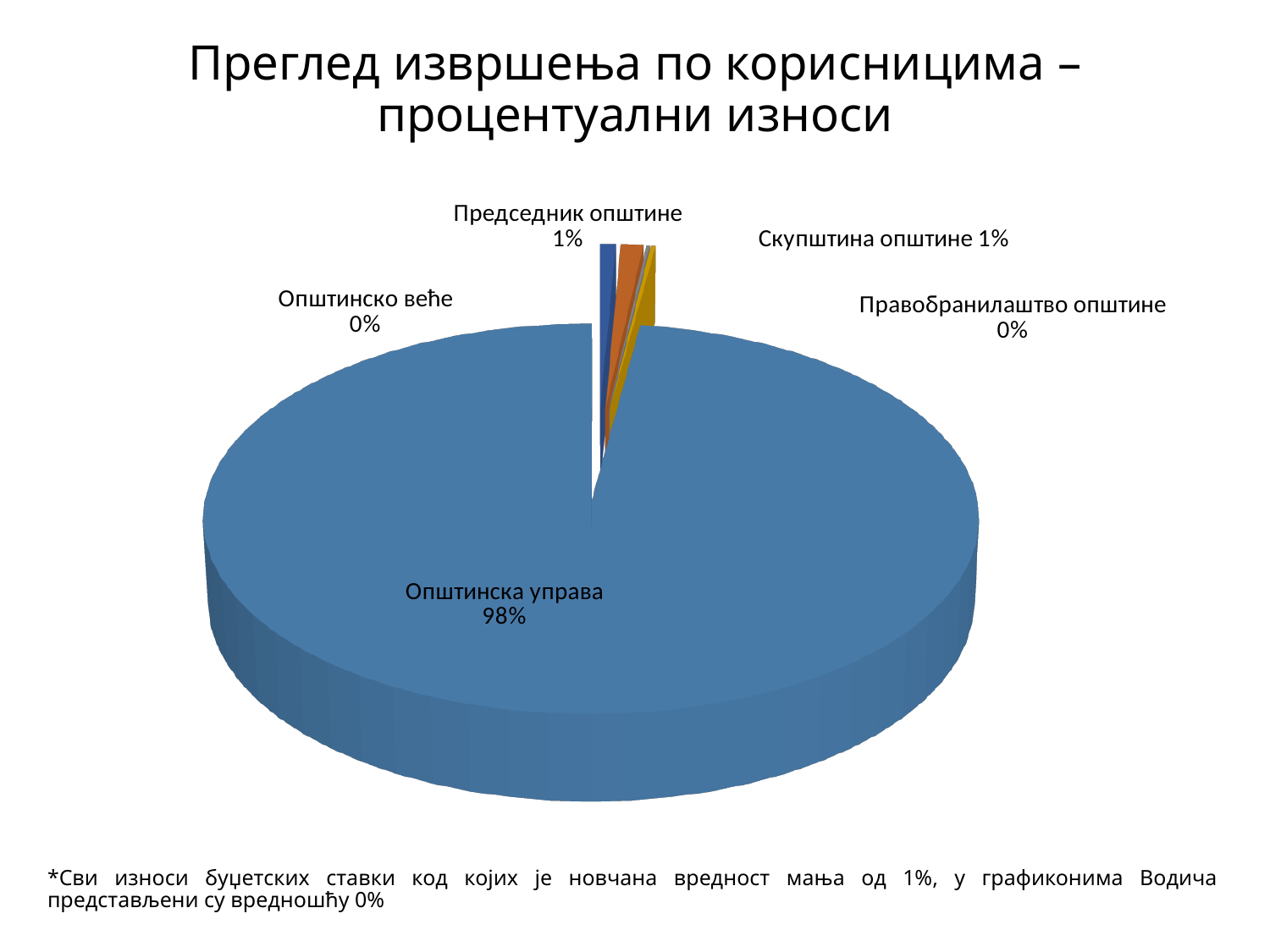
Which category has the largest slice of the pie? Општинска управа How many categories are shown in the pie chart? 5 What share of the pie does Председник општине have? 1% What colour is the slice for Општинска управа? blue What is the title of the chart on the slide? Преглед извршења по корисницима – процентуални износи What is the difference between the share of Општинска управа and the share of Председник општине? 97% What share of the pie does Општинска управа have? 98% Which is larger, the share of Општинска управа or the share of Скупштина општине? Општинска управа What share of the pie does Скупштина општине have? 1% What kind of chart is shown on the slide? pie chart